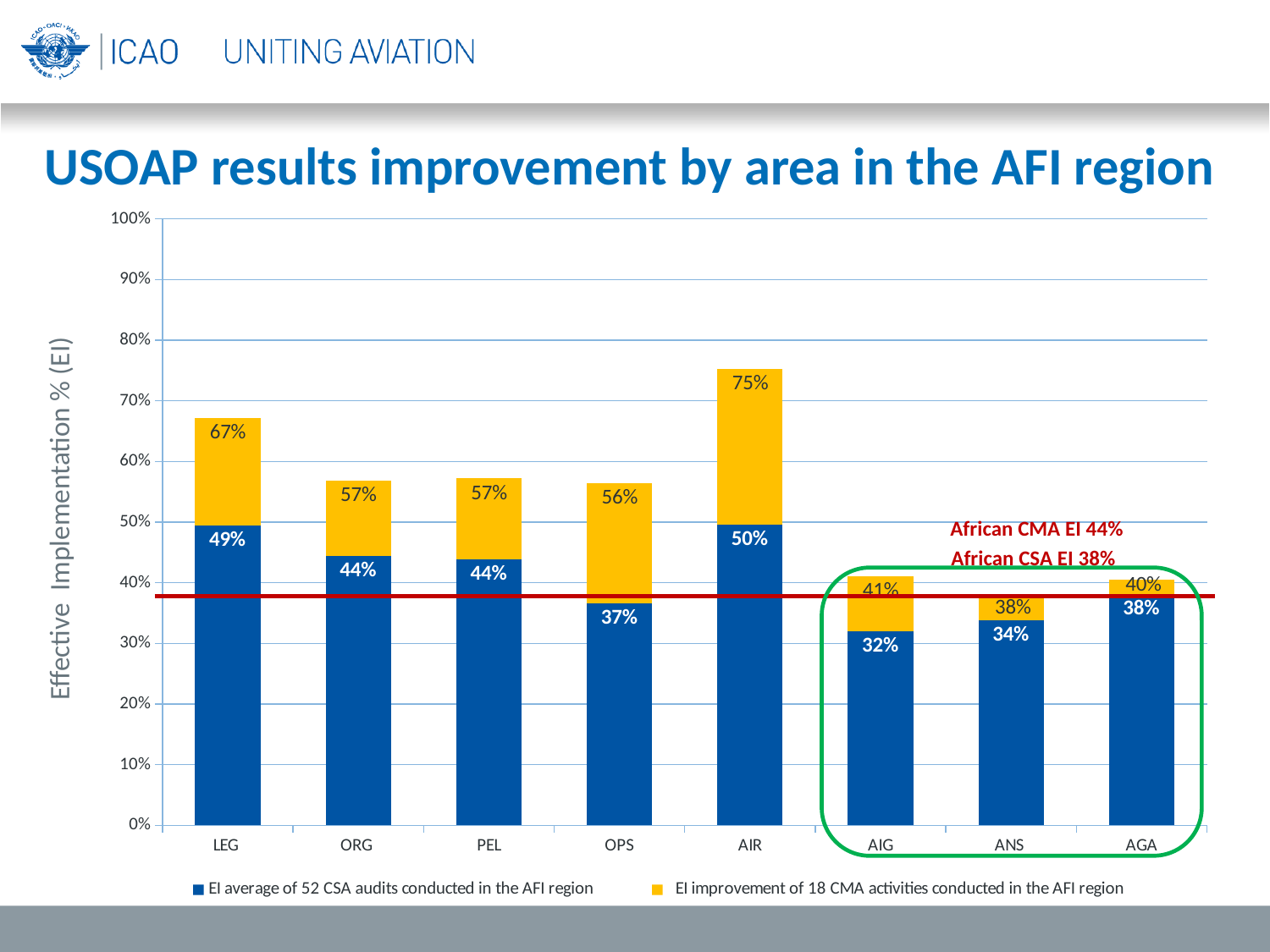
What is the value printed on the yellow segment for AIR? 75% What is the value printed on the blue segment for OPS? 37% What is the value printed on the blue segment for AGA? 38% Which has the larger blue segment value, LEG or ORG? LEG How many series does the legend list? 2 What is the difference between the blue segment values for LEG and AIG? 17% What type of chart is shown on the slide? bar chart Which area has the lowest value printed on its blue segment? AIG Which area has the highest value printed on its blue segment? AIR What is the title of the chart? USOAP results improvement by area in the AFI region Is the blue segment value for ANS greater or less than 40%? less How many areas (categories) are shown on the x axis? 8